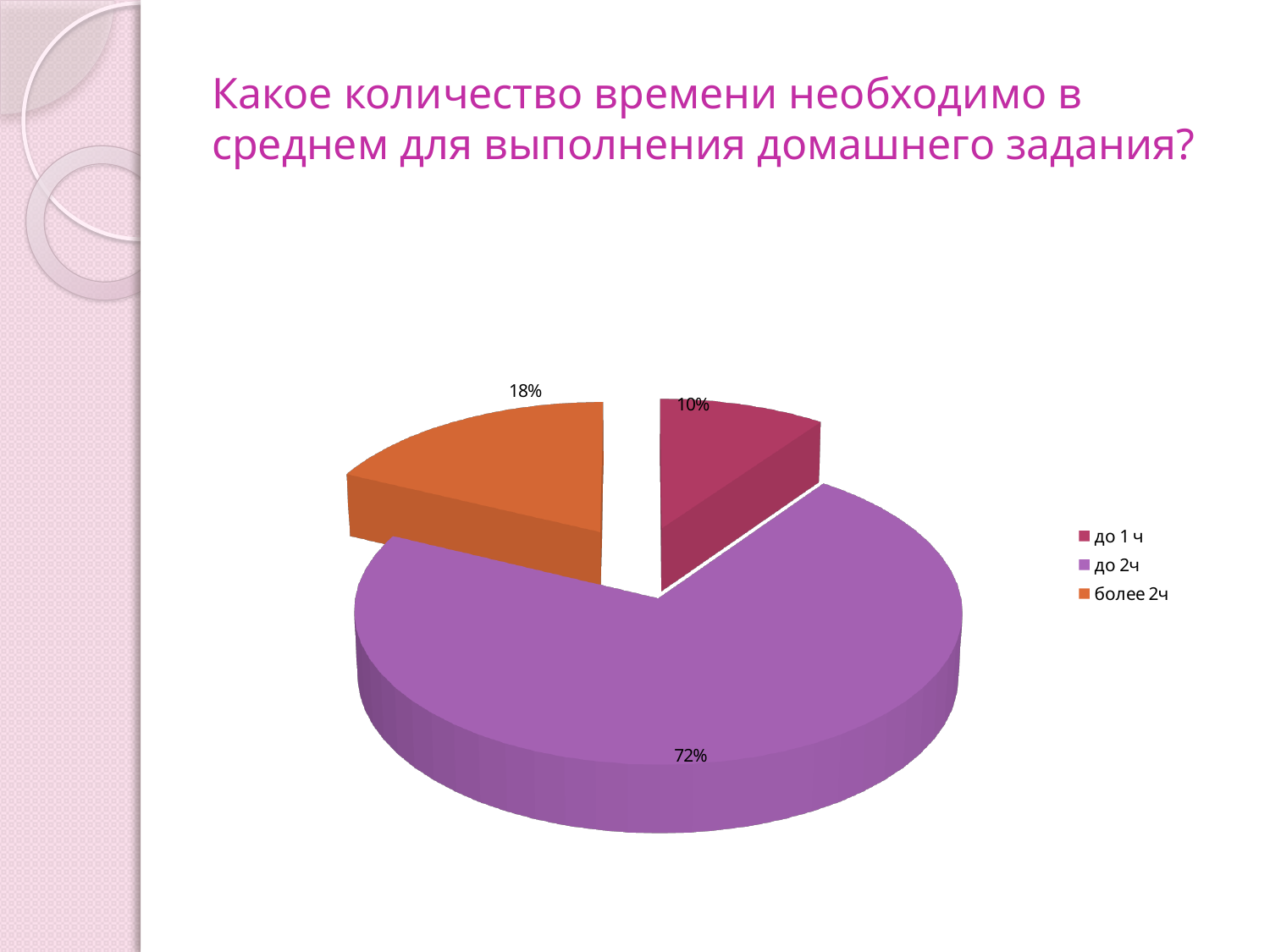
How many entries does the legend list? 3 What colour is the slice for "более 2ч"? orange What share of the pie does "до 1 ч" have? 10% What kind of chart is shown on the slide? pie chart Which category has the largest slice of the pie? до 2ч How many slices does the pie chart have? 3 Which category has the smallest slice of the pie? до 1 ч Which is larger, the slice for "более 2ч" or the slice for "до 1 ч"? более 2ч What is the difference in percentage points between "более 2ч" and "до 1 ч"? 8 What is the difference in percentage points between "до 2ч" and "более 2ч"? 54 What share of the pie does "до 2ч" have? 72% What share of the pie does "более 2ч" have? 18%